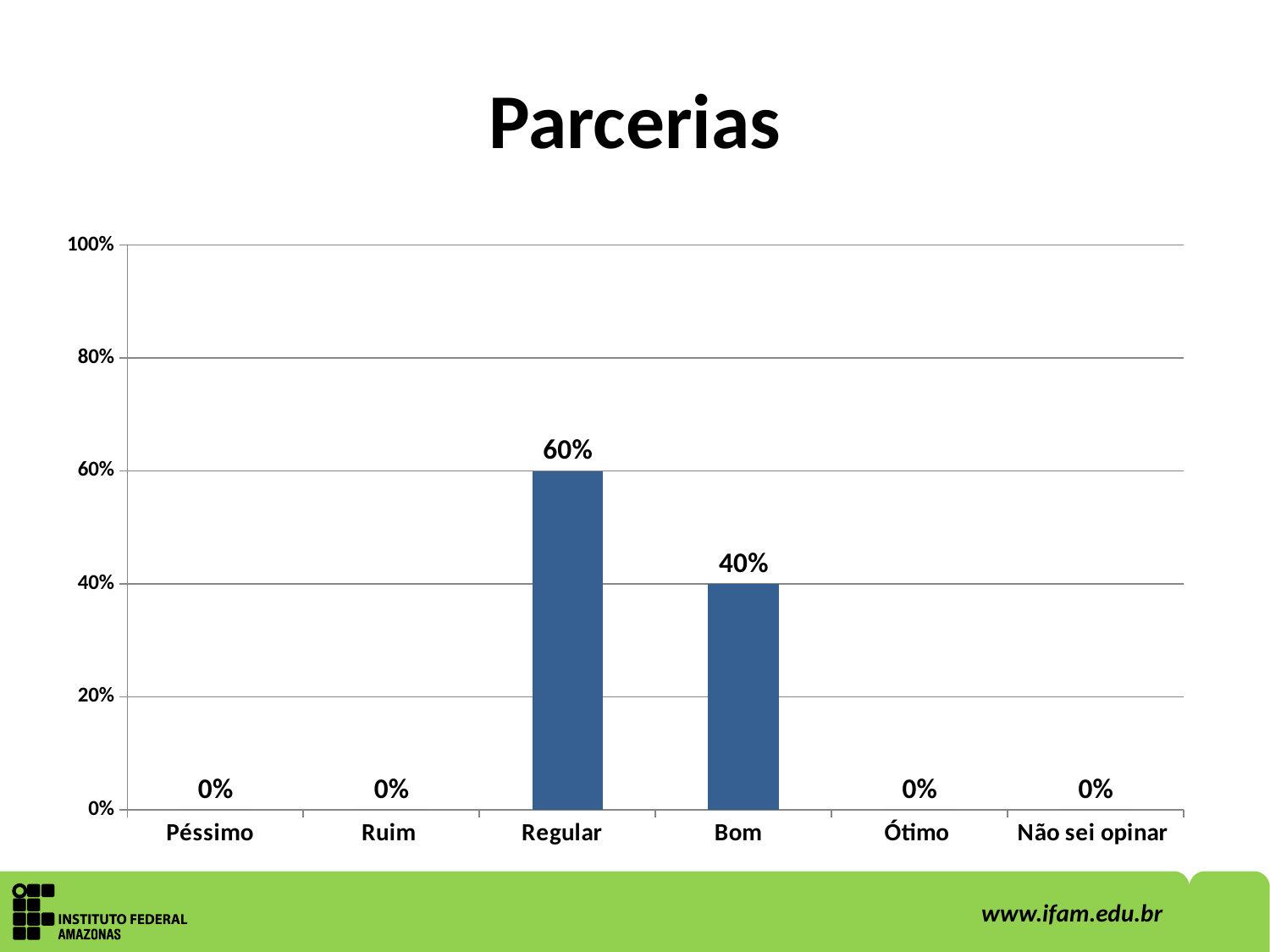
What is the value for Péssimo? 0% What is the value for Não sei opinar? 0% What is the difference between the values for Regular and Bom? 20% What is the value for Regular? 60% What is the title of the chart? Parcerias What is the value for Bom? 40% Is the value for Regular greater or less than 80%? less Which category has the highest value? Regular What kind of chart is shown on the slide? bar chart Which is larger, the value for Regular or the value for Bom? Regular How many categories are shown on the x axis? 6 How many categories have a value of 0%? 4